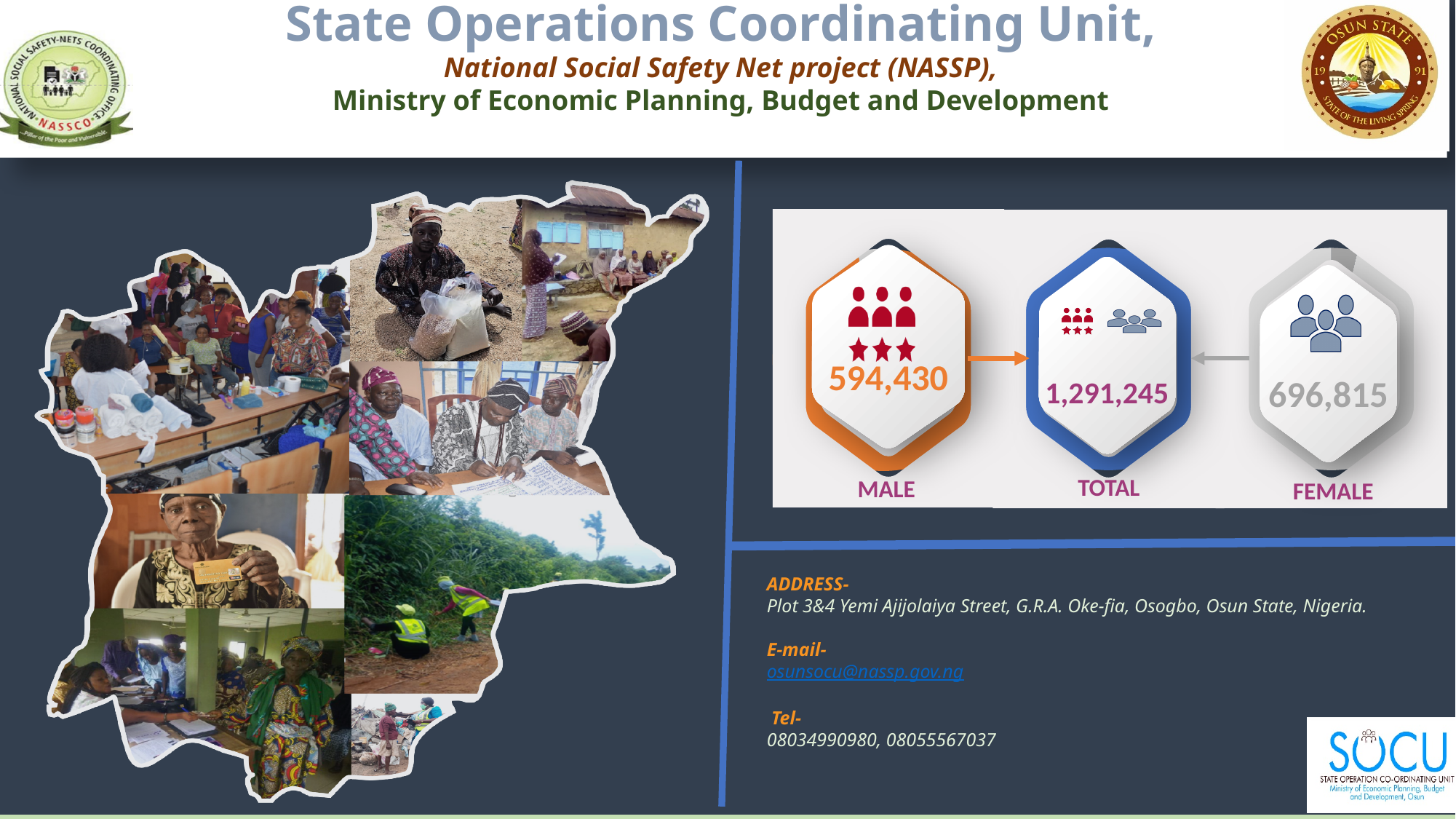
In the infographic on the right, which of the two groups, MALE or FEMALE, has the lower value? MALE In the infographic on the right, what is the value shown for FEMALE? 696,815 In the infographic on the right, what is the difference between the FEMALE value and the MALE value? 102,385 How many labelled hexagons are shown in the infographic on the right? 3 In the infographic on the right, is the MALE value greater or less than 600,000? less In the infographic on the right, what is the value shown for TOTAL? 1,291,245 In the infographic on the right, what is the sum of the MALE and FEMALE values? 1,291,245 In the infographic on the right, what is the value shown for MALE? 594,430 In the infographic on the right, what colour is the border of the TOTAL hexagon? Blue In the infographic on the right, is the FEMALE value greater or less than 650,000? greater In the infographic on the right, what colour is the border of the MALE hexagon? Orange In the infographic on the right, which is larger, the MALE value or the FEMALE value? FEMALE